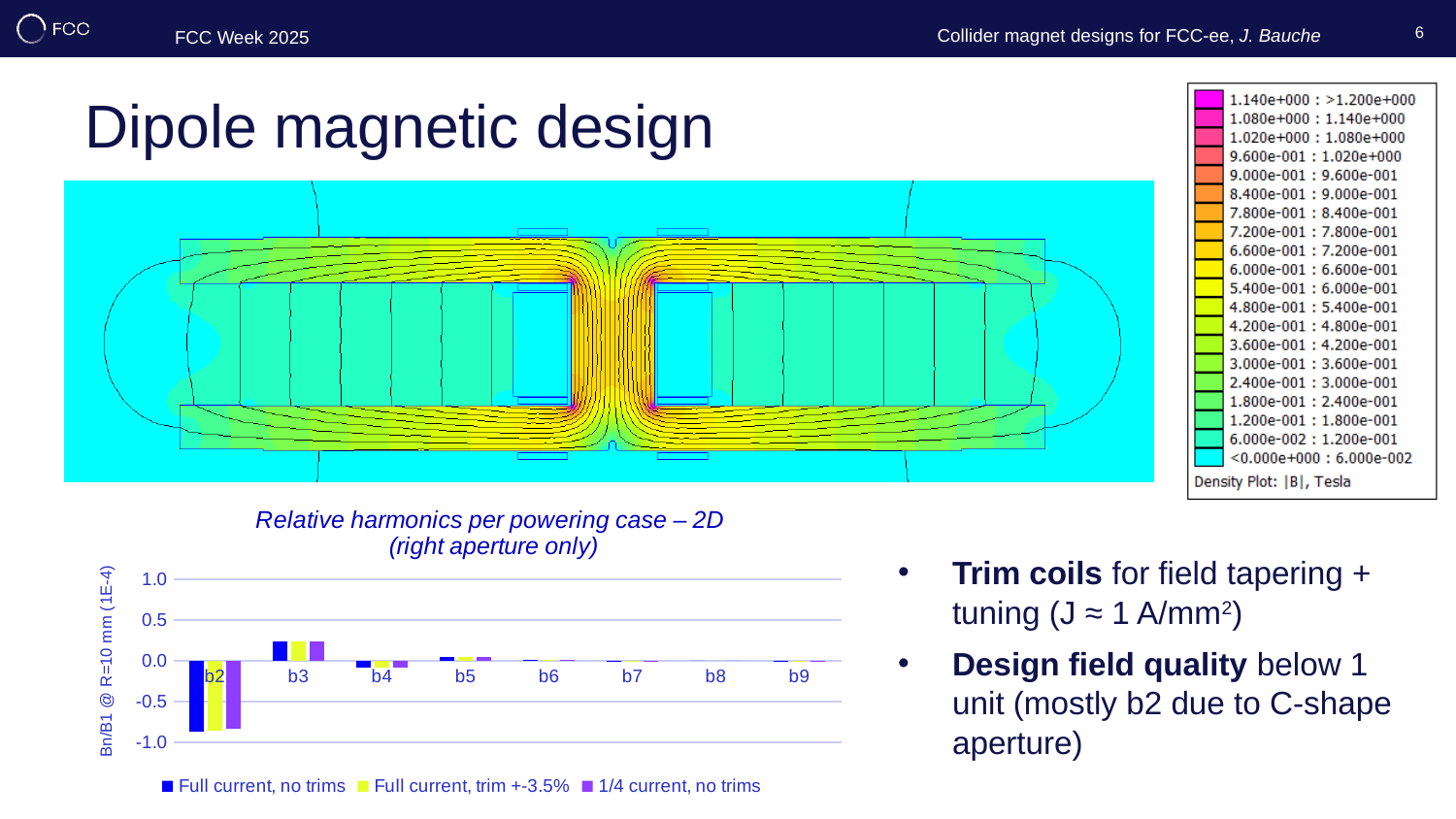
Is the value for b2 in the 'Full current, trim +-3.5%' series greater or less than 0.0? less Is the value for b2 in the 'Full current, no trims' series greater or less than -0.5? less What is the title of the bar chart? Relative harmonics per powering case – 2D (right aperture only) Is the value for b3 in the '1/4 current, no trims' series greater or less than 0.0? greater What is the label of the y axis of the bar chart? Bn/B1 @ R=10 mm (1E-4) How many harmonic categories are shown on the x axis of the bar chart? 8 Which is larger in the 'Full current, no trims' series: the value for b2 or the value for b3? b3 Which harmonic has the lowest (most negative) values in the bar chart? b2 What kind of chart is shown on the slide? bar chart How many series does the legend of the bar chart list? 3 Which harmonic has the highest positive values in the bar chart? b3